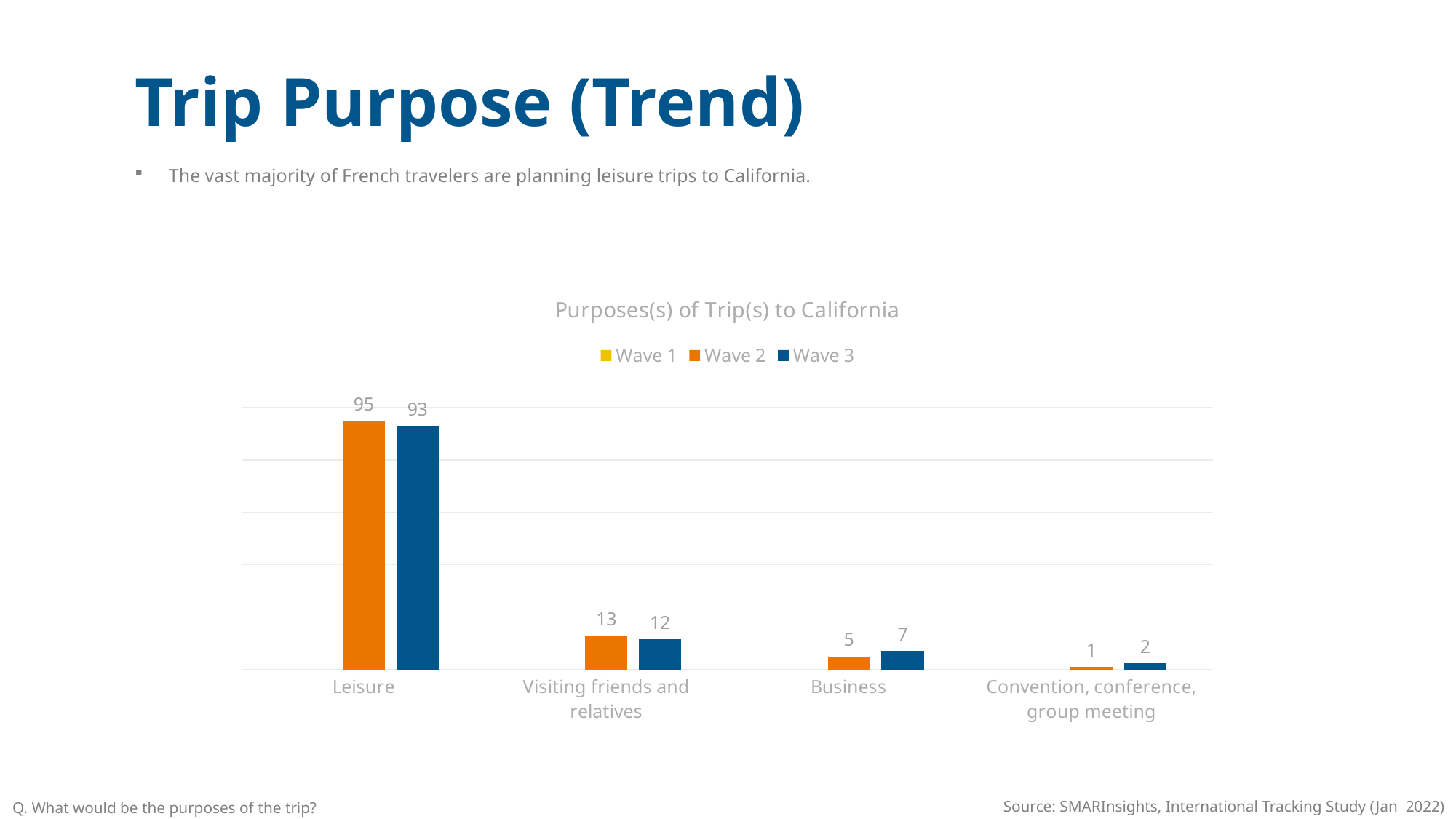
What is the Wave 2 value for Convention, conference, group meeting? 1 Which category has the lowest Wave 2 value? Convention, conference, group meeting How many categories are shown on the x axis? 4 What is the Wave 3 value for Visiting friends and relatives? 12 For Business, which is larger: the Wave 2 value or the Wave 3 value? Wave 3 What is the Wave 2 value for Leisure? 95 What is the Wave 3 value for Business? 7 Which category has the highest Wave 3 value? Leisure How many series does the legend list? 3 What kind of chart is shown on the slide? Bar chart What is the difference between the Wave 2 and Wave 3 values for Leisure? 2 What is the title of the chart? Purposes(s) of Trip(s) to California